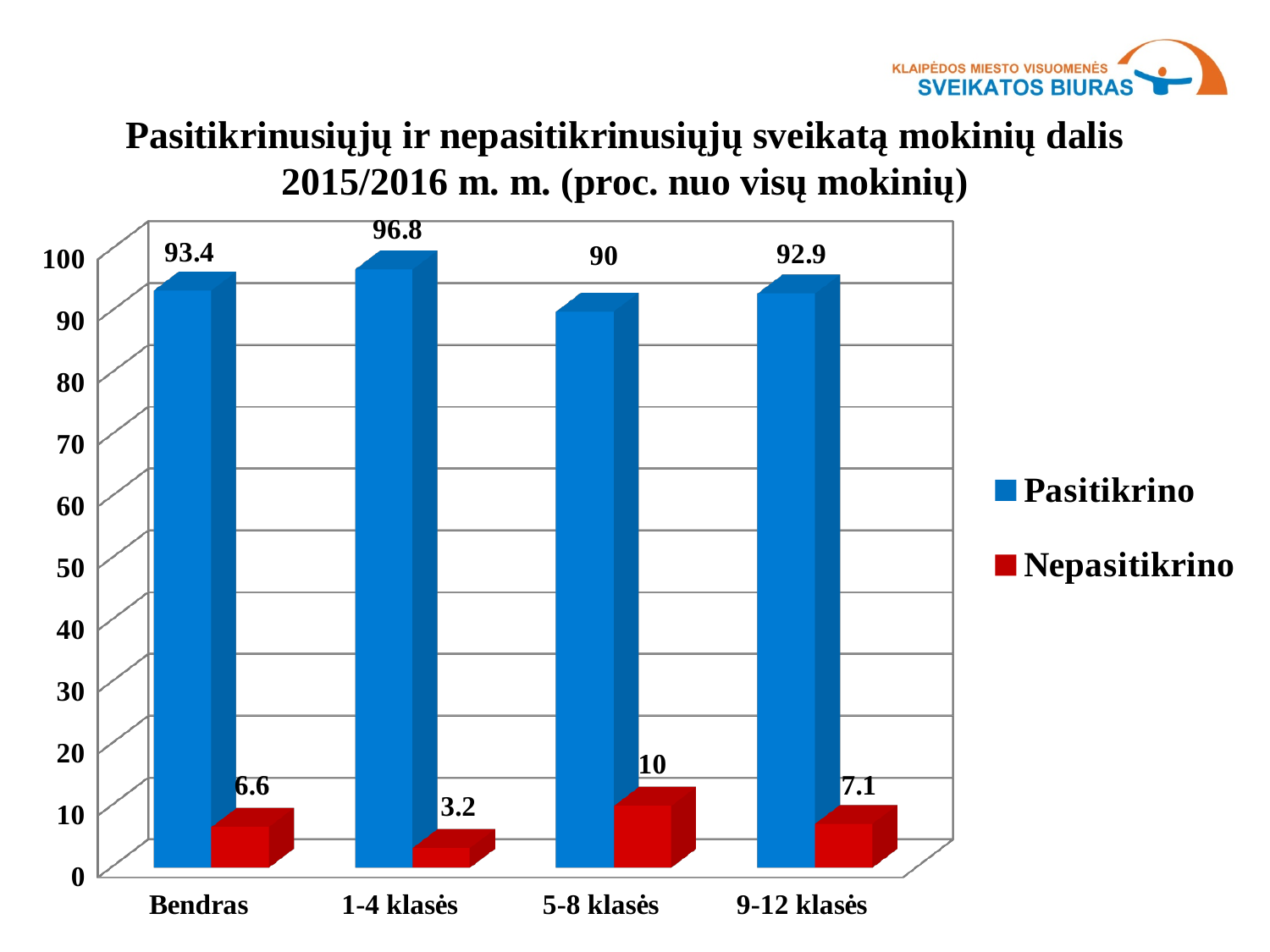
How many series does the legend list? 2 How many categories are shown on the x axis? 4 Which colour represents the Nepasitikrino series? Red Which is larger, the Nepasitikrino value for Bendras or for 9-12 klasės? 9-12 klasės What is the Nepasitikrino value for 5-8 klasės? 10 Which category has the lowest Nepasitikrino value? 1-4 klasės Which category has the highest Pasitikrino value? 1-4 klasės What is the Nepasitikrino value for 9-12 klasės? 7.1 What kind of chart is shown on the slide? Bar chart What is the difference between the Pasitikrino values for 1-4 klasės and 5-8 klasės? 6.8 What is the Pasitikrino value for 1-4 klasės? 96.8 What is the Pasitikrino value for Bendras? 93.4